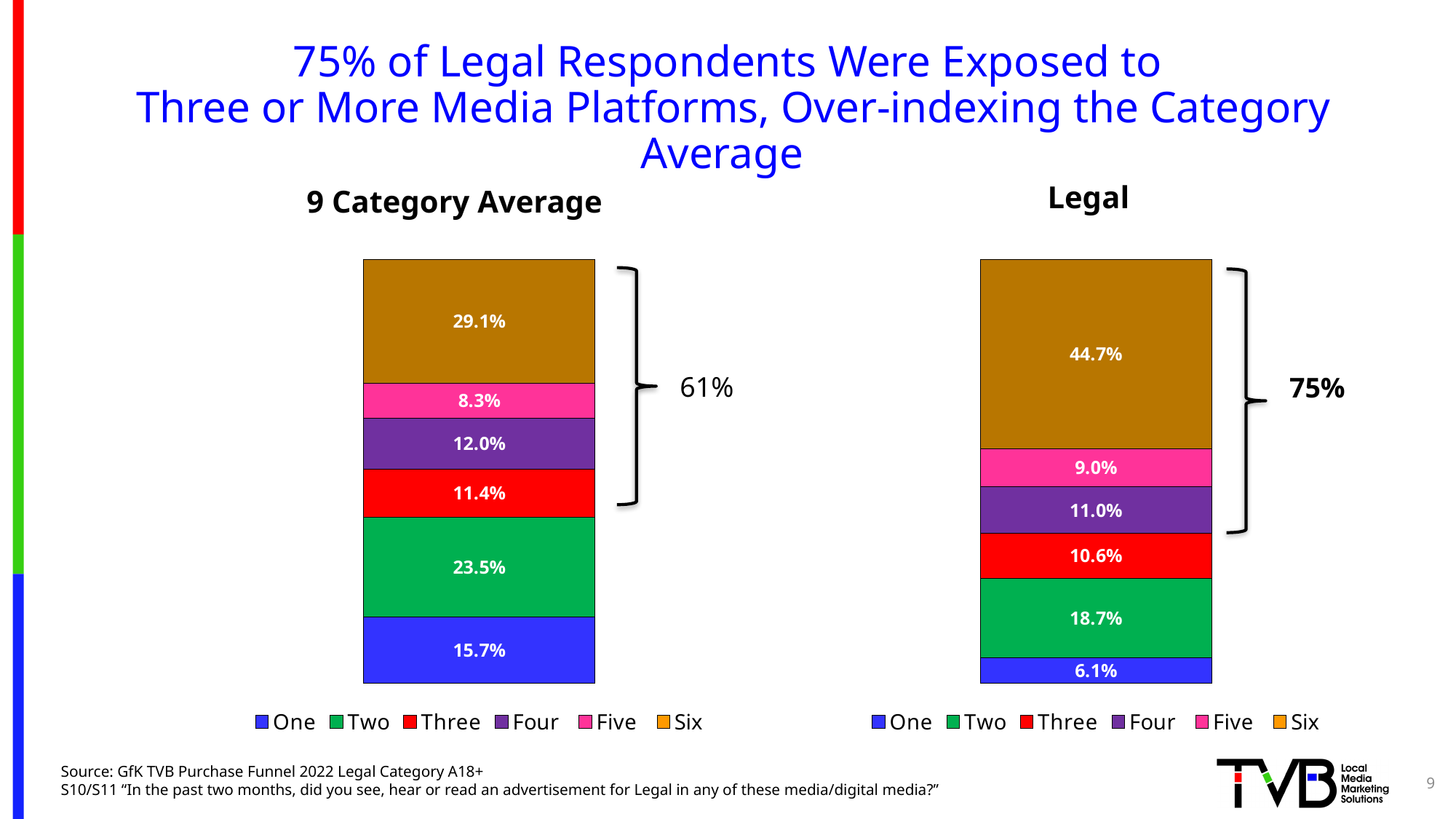
In the Legal chart, what is the value for Six? 44.7% What percentage is shown next to the bracket on the Legal chart? 75% What is the difference between the value for Six in the Legal chart and the value for Six in the 9 Category Average chart? 15.6% In the Legal chart, what is the value for One? 6.1% In the Legal chart, which segment has the smallest value? One In the 9 Category Average chart, which segment has the smallest value? Five In the Legal chart, which segment has the largest value? Six How many series does the legend of the Legal chart list? 6 Which is larger: the value for Two in the 9 Category Average chart or the value for Two in the Legal chart? 9 Category Average In the 9 Category Average chart, what is the value for Six? 29.1% What kind of chart is the 9 Category Average chart? Stacked bar chart In the 9 Category Average chart, what is the value for Two? 23.5%